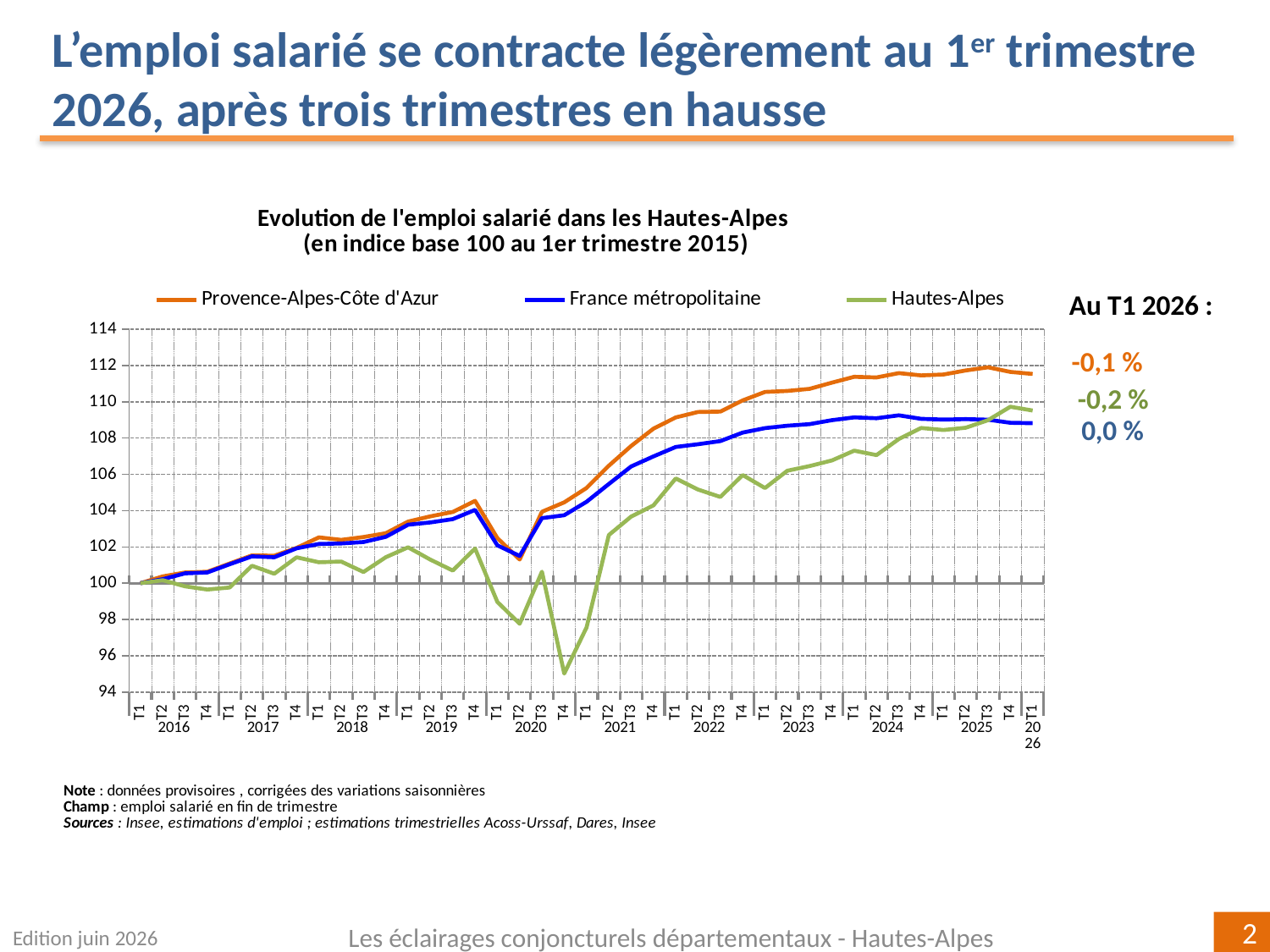
What type of chart is shown on the slide? line chart Is the Hautes-Alpes index at T4 2020 greater or less than 96? less Which series has the highest index value at T1 2026? Provence-Alpes-Côte d'Azur Which series is drawn in green? Hautes-Alpes At T1 2026, which is larger: the index for Provence-Alpes-Côte d'Azur or for France métropolitaine? Provence-Alpes-Côte d'Azur Which series has the lowest index value at T4 2020? Hautes-Alpes According to the annotation, what is the change for France métropolitaine at T1 2026? 0,0 % Is the Provence-Alpes-Côte d'Azur index at T1 2026 greater or less than 110? greater According to the annotation, what is the change for Provence-Alpes-Côte d'Azur at T1 2026? -0,1 % How many series does the legend list? 3 According to the annotation, what is the change for Hautes-Alpes at T1 2026? -0,2 % What is the title of the chart? Evolution de l'emploi salarié dans les Hautes-Alpes (en indice base 100 au 1er trimestre 2015)